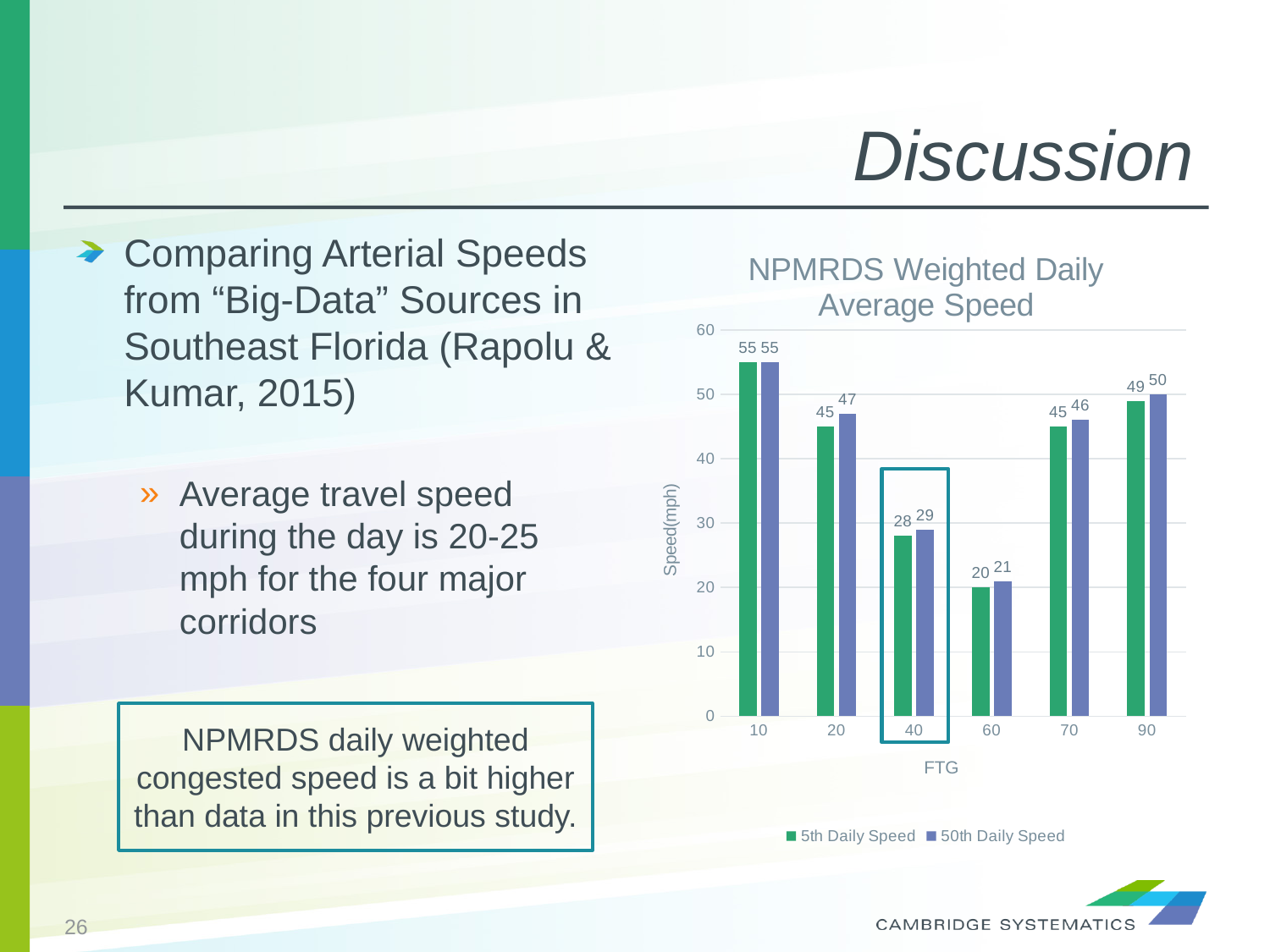
Which is larger: the 50th Daily Speed for FTG 40 or for FTG 60? FTG 40 What is the 50th Daily Speed value for FTG 70? 46 What is the difference between the 50th Daily Speed and the 5th Daily Speed for FTG 20? 2 How many FTG categories are shown on the x axis? 6 What is the difference between the 5th Daily Speed for FTG 10 and for FTG 60? 35 How many series does the legend list? 2 What is the title of the chart? NPMRDS Weighted Daily Average Speed Which FTG category has the lowest 5th Daily Speed? 60 Which FTG category has the highest 50th Daily Speed? 10 What is the 5th Daily Speed value for FTG 40? 28 What is the 50th Daily Speed value for FTG 90? 50 What kind of chart is shown on the slide? Bar chart